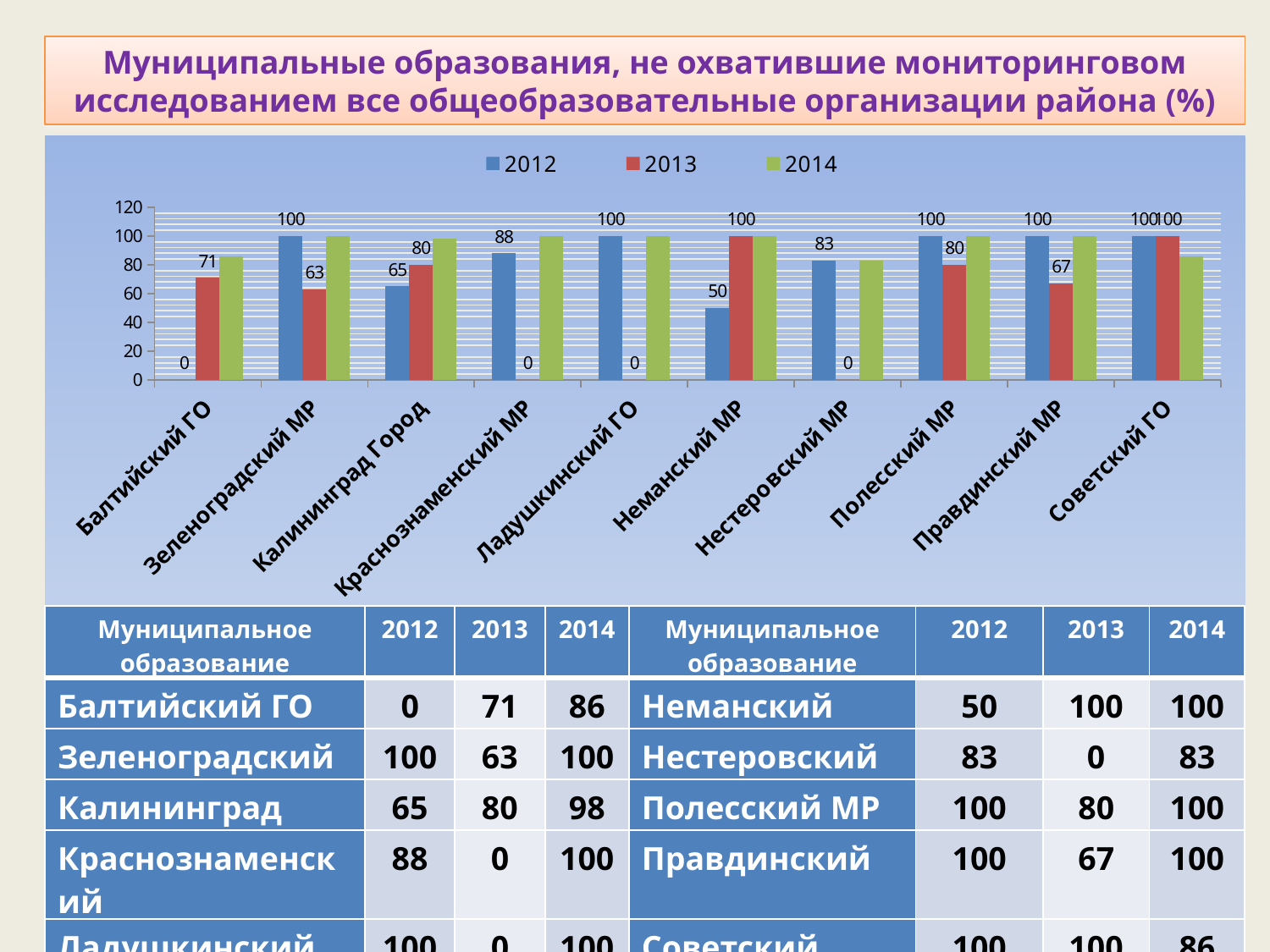
What is the difference between the 2013 and 2012 values for Калининград Город? 15 Which municipality has the lowest 2012 value? Балтийский ГО Is the 2014 value for Калининград Город greater or less than 80? greater What is the 2013 value for Правдинский МР? 67 What is the 2012 value for Неманский МР? 50 What is the 2013 value for Балтийский ГО? 71 What are the entries in the chart legend? 2012, 2013, 2014 For Зеленоградский МР, which is larger: the 2012 value or the 2013 value? 2012 What kind of chart is shown on the slide? bar chart How many series does the chart legend list? 3 What is the 2012 value for Нестеровский МР? 83 How many municipalities are shown on the x axis of the chart? 10